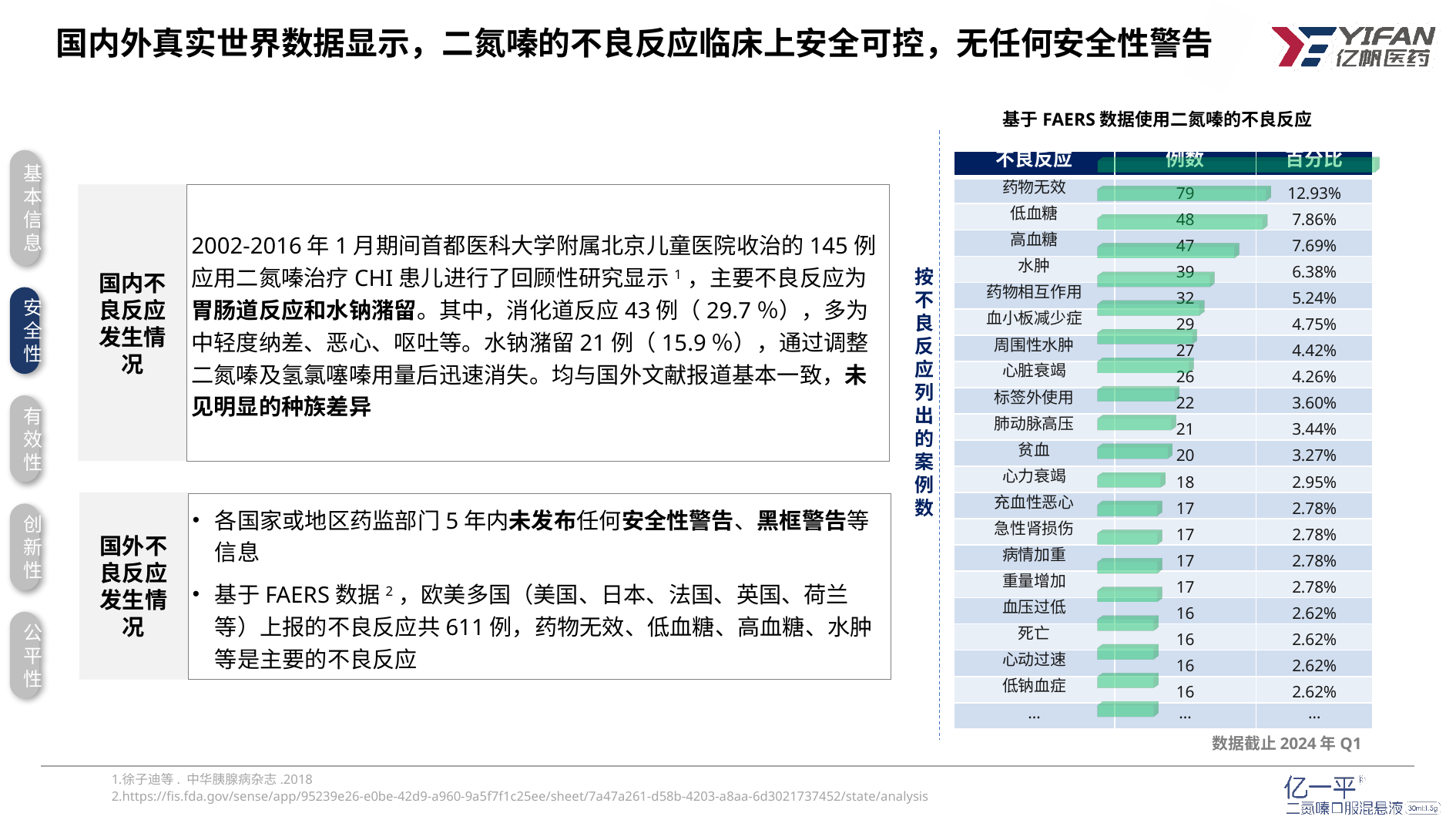
In the chart 基于 FAERS 数据使用二氮嗪的不良反应, which has more cases, 高血糖 or 水肿? 高血糖 In the chart 基于 FAERS 数据使用二氮嗪的不良反应, what is the percentage for 血小板减少症? 4.75% In the chart 基于 FAERS 数据使用二氮嗪的不良反应, how many cases (例数) are listed for 药物无效? 79 In the chart 基于 FAERS 数据使用二氮嗪的不良反应, how many cases are listed for 水肿? 39 What is the title of the chart on the right side of the slide? 基于 FAERS 数据使用二氮嗪的不良反应 In the chart 基于 FAERS 数据使用二氮嗪的不良反应, what is the percentage (百分比) for 低血糖? 7.86% In the chart 基于 FAERS 数据使用二氮嗪的不良反应, what is the difference in cases between 心脏衰竭 and 心力衰竭? 8 In the chart 基于 FAERS 数据使用二氮嗪的不良反应, do the case counts rise or fall going down the list from 药物无效 to 低钠血症? fall In the chart 基于 FAERS 数据使用二氮嗪的不良反应, what is the difference in cases between 药物无效 and 低血糖? 31 What kind of chart is used in 基于 FAERS 数据使用二氮嗪的不良反应? bar chart In the chart 基于 FAERS 数据使用二氮嗪的不良反应, which adverse reaction has the highest number of cases? 药物无效 In the chart 基于 FAERS 数据使用二氮嗪的不良反应, how many named adverse reactions are listed (excluding the '...' row)? 20